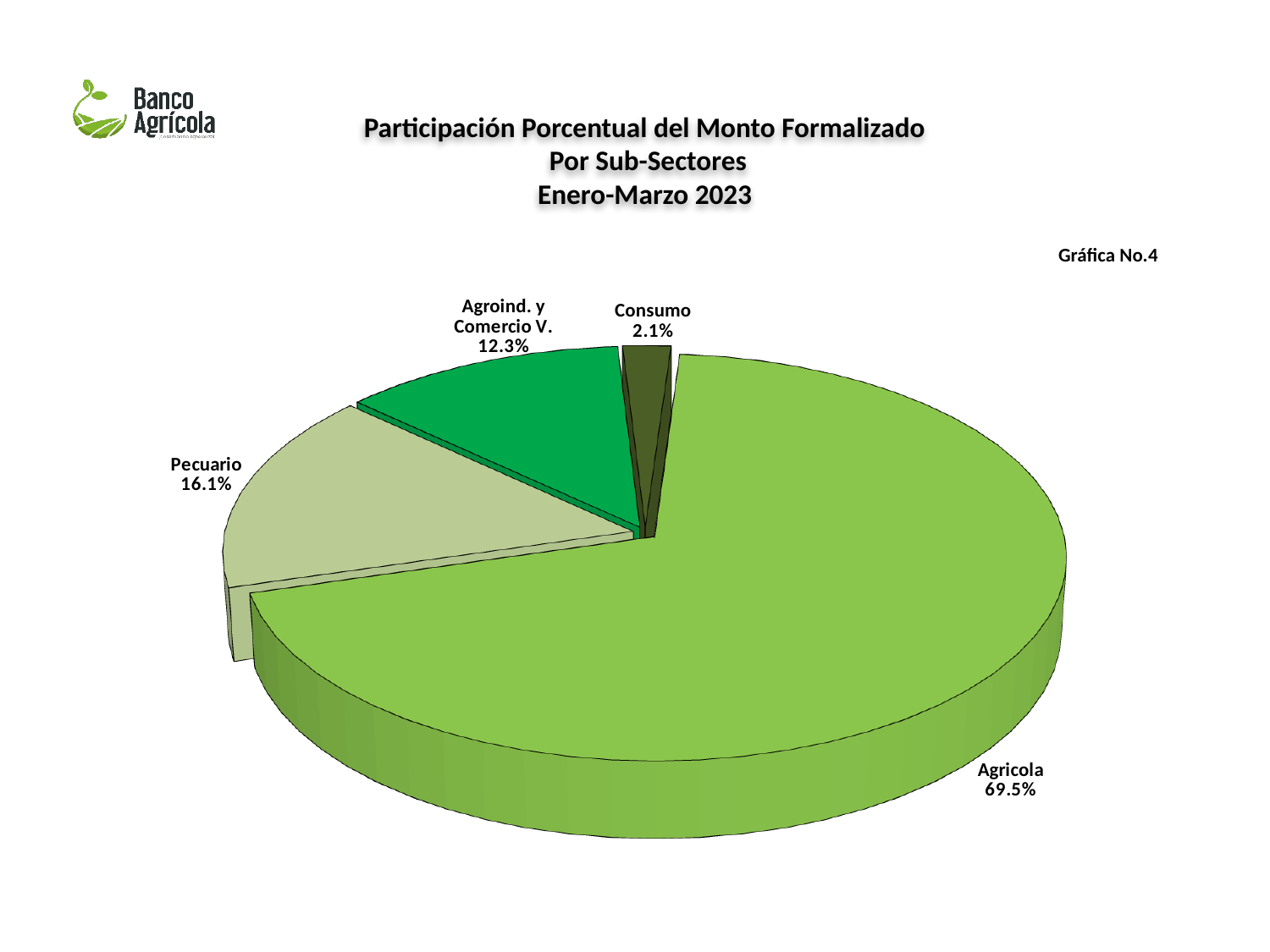
How many slices does the pie chart have? 4 Which sub-sector has the largest share? Agricola What is the share for Consumo? 2.1% What is the difference in percentage points between Pecuario and Agroind. y Comercio V.? 3.8 Which is larger, the share for Pecuario or the share for Agroind. y Comercio V.? Pecuario Which sub-sector has the smallest share? Consumo What is the share for Agricola? 69.5% What is the share for Agroind. y Comercio V.? 12.3% What is the difference in percentage points between Agricola and Consumo? 67.4 What period does the chart title say the data covers? Enero-Marzo 2023 What is the share for Pecuario? 16.1% What kind of chart is shown on the slide? Pie chart